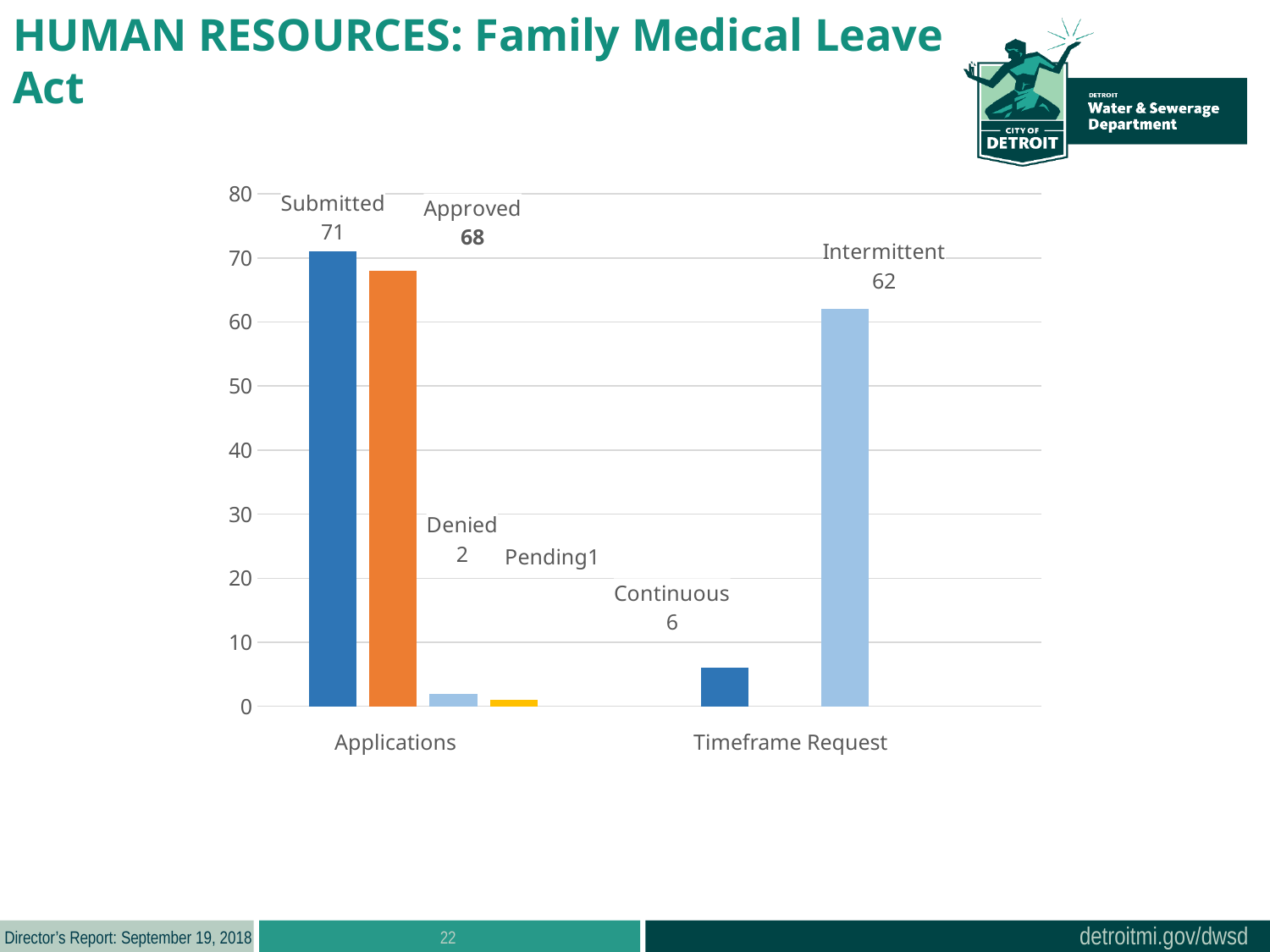
What is the difference between Intermittent and Continuous timeframe requests? 56 Which is larger, Approved applications or Intermittent timeframe requests? Approved What is the value for Submitted applications? 71 What is the value for Intermittent timeframe requests? 62 What is the value for Denied applications? 2 What is the value for Pending applications? 1 What is the value for Continuous timeframe requests? 6 Which bar has the lowest value on the chart? Pending What kind of chart is shown on the slide? Bar chart What is the difference between Submitted and Approved applications? 3 What is the value for Approved applications? 68 Which bar has the highest value on the chart? Submitted